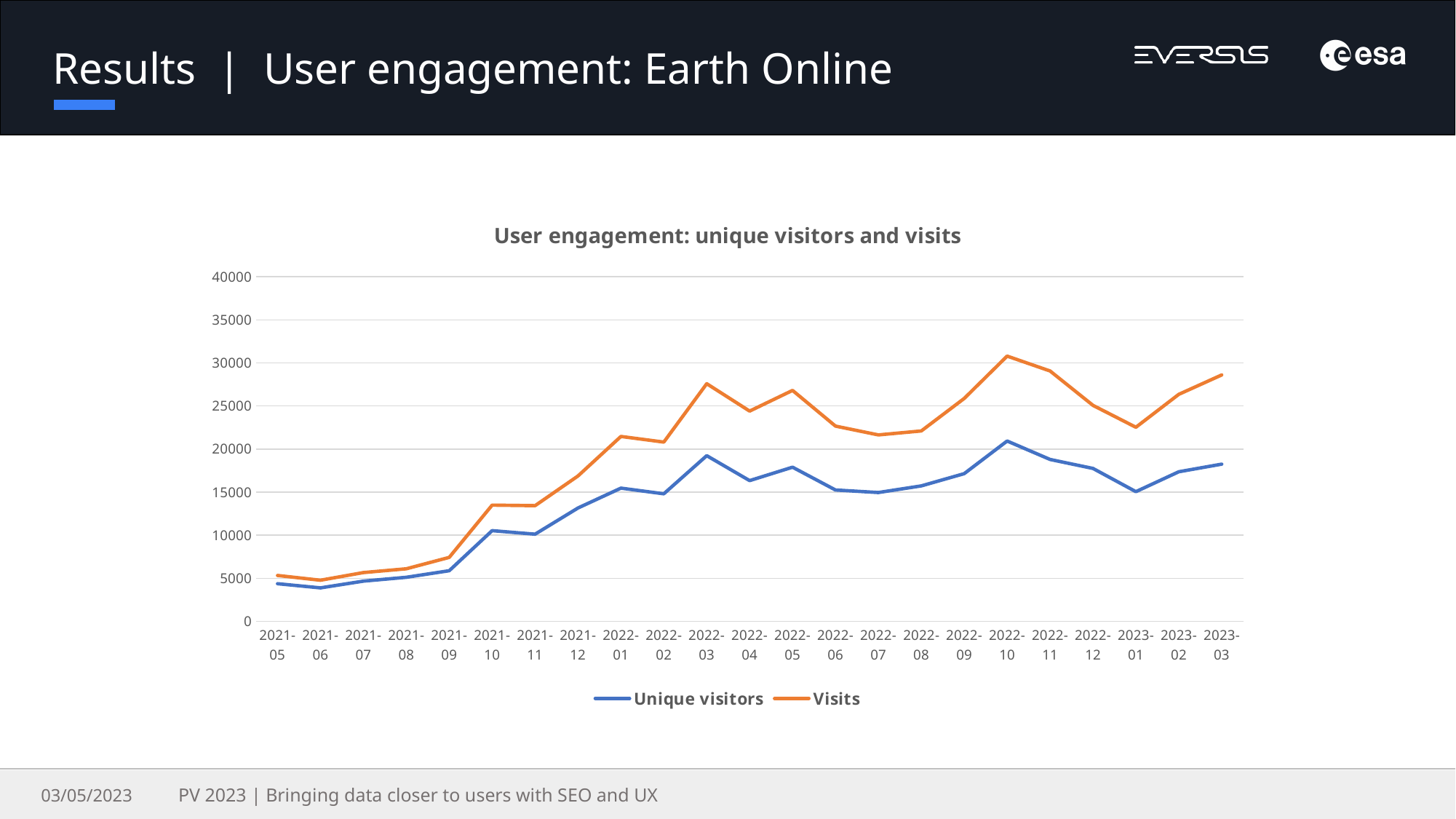
Is the value for Unique visitors in 2021-05 greater or less than 10000? less Which series has the larger value in 2022-03, Unique visitors or Visits? Visits What is the title of the chart? User engagement: unique visitors and visits What kind of chart is shown on the slide? Line chart Is the value for Visits in 2022-10 greater or less than 30000? greater Overall, do the values rise or fall from 2021-05 to 2023-03? Rise Is the value for Visits in 2023-01 greater or less than 25000? less How many months (points) are plotted along the x axis? 23 In which month is the Unique visitors series at its lowest? 2021-06 In which month does the Visits series reach its highest value? 2022-10 In which month does the Unique visitors series reach its highest value? 2022-10 How many series does the legend list? 2